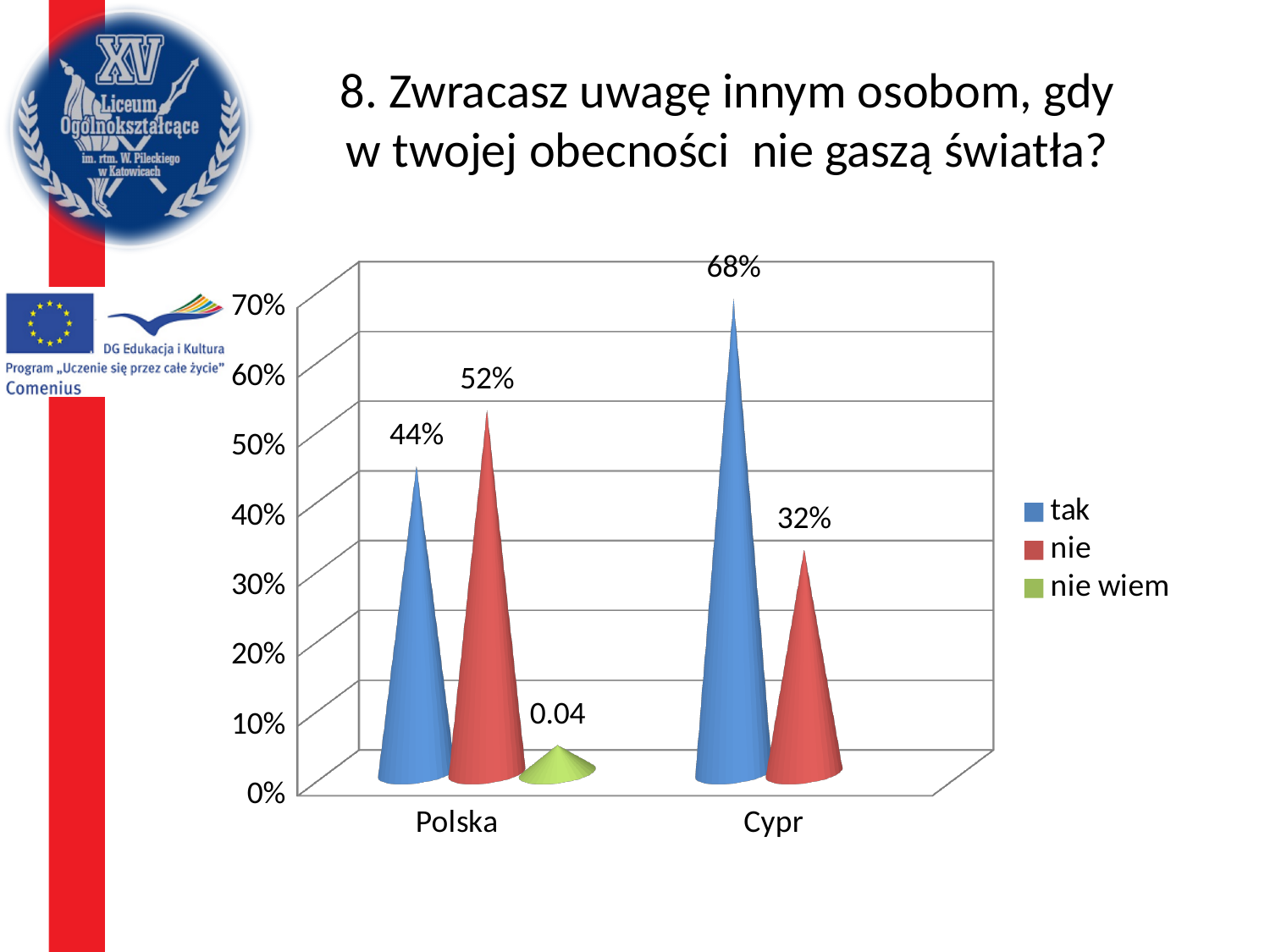
What data label is shown for "nie wiem" in Polska? 0.04 What is the value for "nie" in Polska? 52% How many series does the legend list? 3 What is the value for "tak" in Cypr? 68% What kind of chart is shown on the slide? bar chart Which is larger in Polska, "tak" or "nie"? nie What is the value for "nie" in Cypr? 32% What is the difference between the "tak" values for Cypr and Polska? 24% Which category has the lowest value for "nie"? Cypr How many categories are shown on the x axis? 2 Which category has the highest value for "tak"? Cypr What is the value for "tak" in Polska? 44%